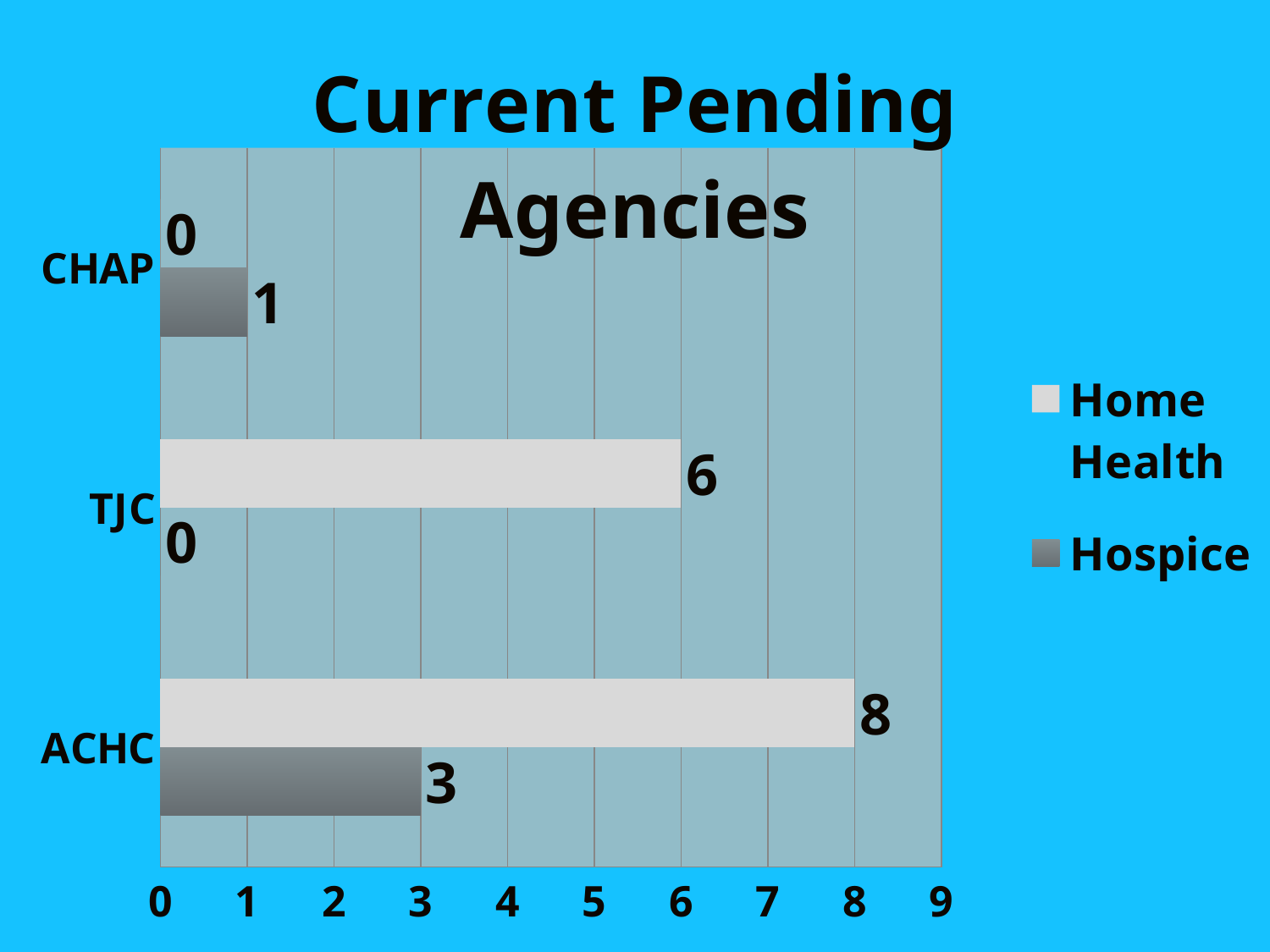
What kind of chart is shown on the slide? Bar chart What is the Home Health value for CHAP? 0 What is the Home Health value for TJC? 6 Which agency has the highest Home Health value? ACHC What is the difference between the Home Health and Hospice values for ACHC? 5 How many series does the legend list? 2 How many agencies are shown on the chart? 3 Which agency has the lowest Hospice value? TJC What is the Hospice value for ACHC? 3 Which is larger, the Home Health value for TJC or the Home Health value for ACHC? ACHC What is the Hospice value for CHAP? 1 What is the Home Health value for ACHC? 8